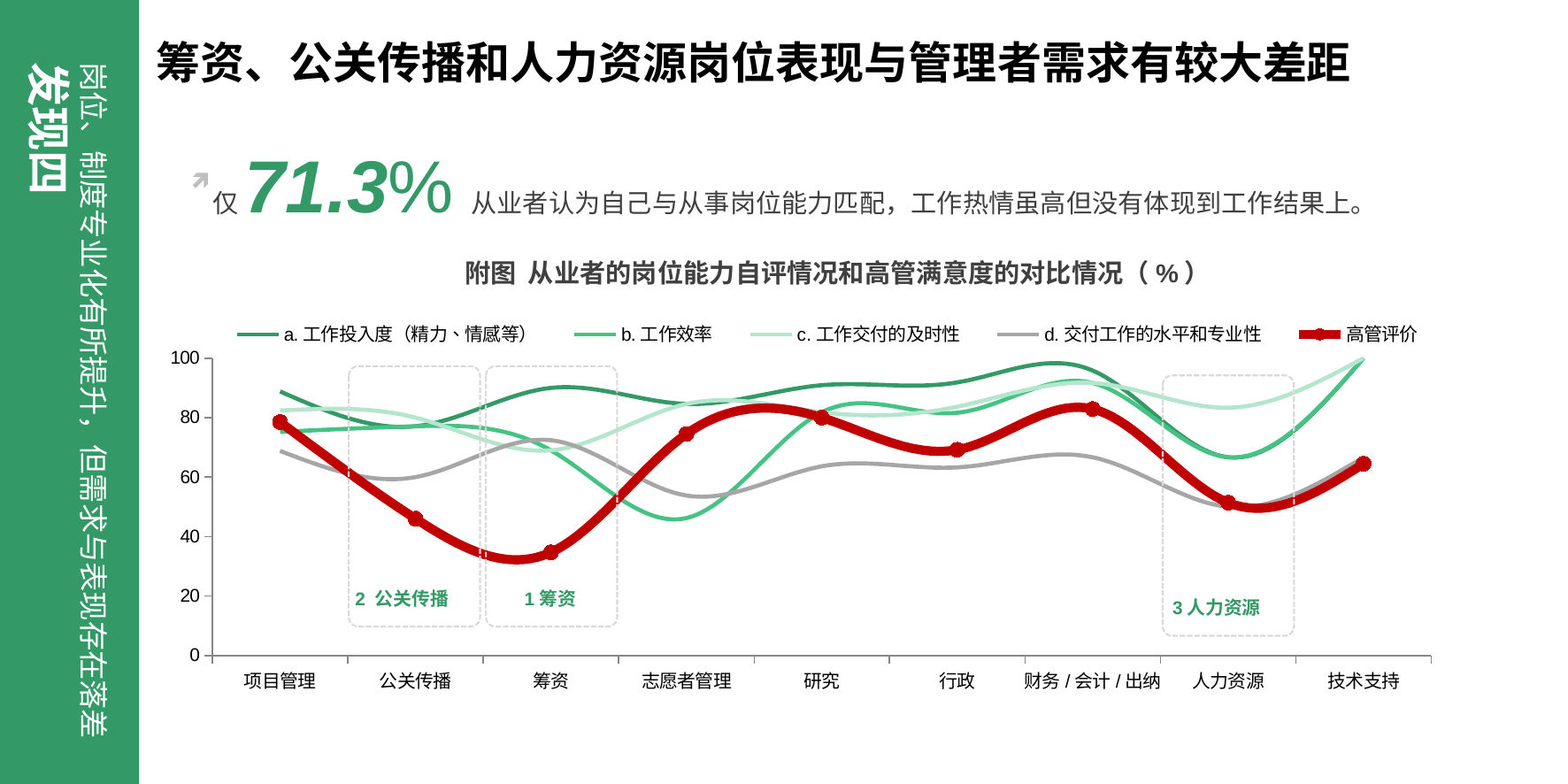
What kind of chart is shown on the slide? line chart At 筹资, which is larger: a. 工作投入度（精力、情感等） or 高管评价? a. 工作投入度（精力、情感等） For the 高管评价 series, which category has the lowest value? 筹资 Is the b. 工作效率 value for 志愿者管理 greater or less than 60? less How many series does the legend list? 5 What is the title of the chart? 附图 从业者的岗位能力自评情况和高管满意度的对比情况（%） How many job categories are shown on the x axis? 9 Is the c. 工作交付的及时性 value for 技术支持 greater or less than 80? greater Does the 高管评价 series rise or fall from 项目管理 to 筹资? fall Is the 高管评价 value for 公关传播 greater or less than 60? less